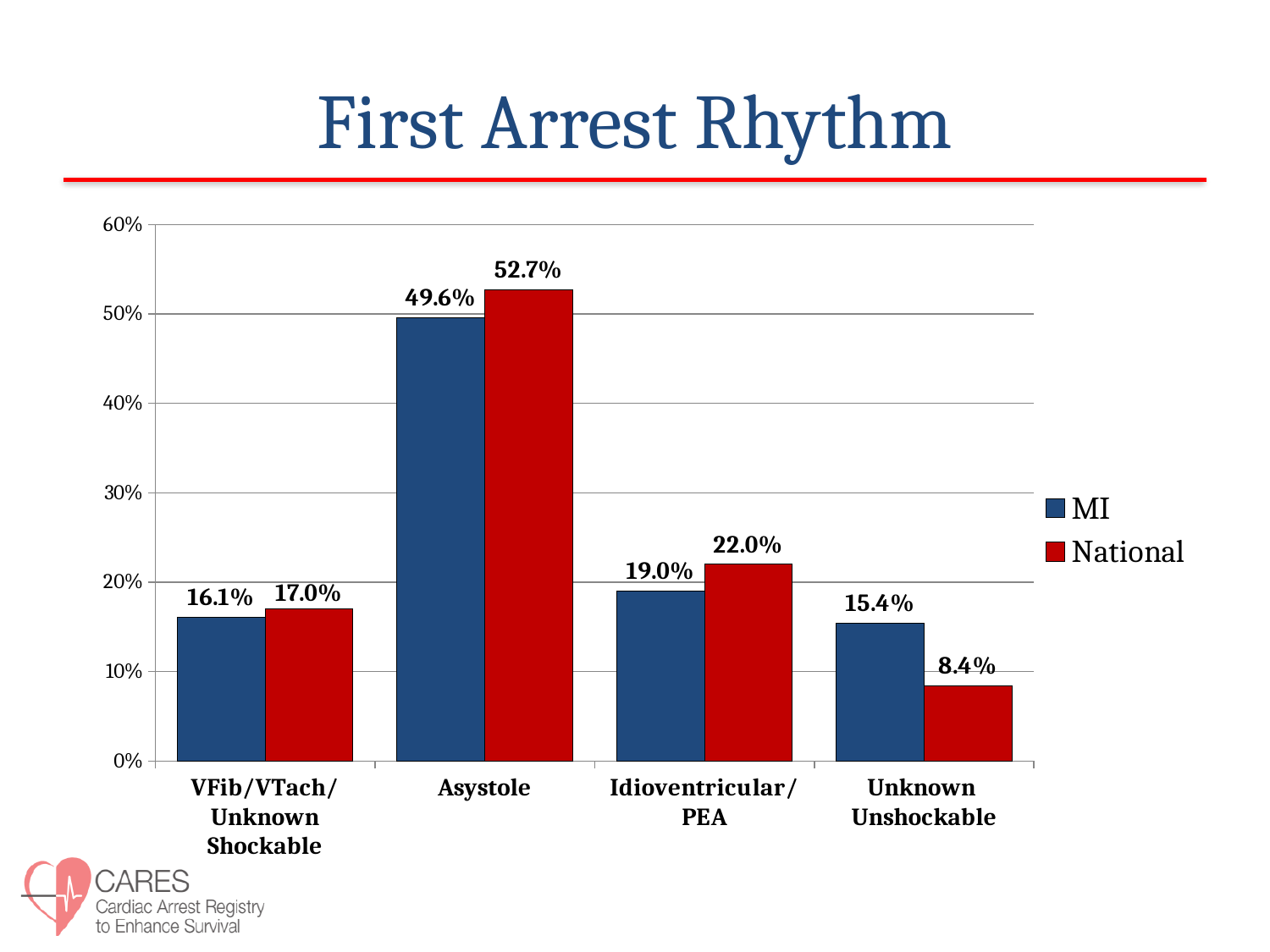
How many categories are shown on the x axis? 4 What is the National value for Unknown Unshockable? 8.4% Which category has the lowest MI value? Unknown Unshockable What is the MI value for VFib/VTach/Unknown Shockable? 16.1% Which category has the highest National value? Asystole What is the difference between the MI and National values for Unknown Unshockable? 7.0% What is the National value for Idioventricular/PEA? 22.0% What is the difference between the National and MI values for Asystole? 3.1% How many series does the legend list? 2 What type of chart is shown on the slide? Bar chart What is the MI value for Asystole? 49.6% For Idioventricular/PEA, which is larger: the MI value or the National value? National